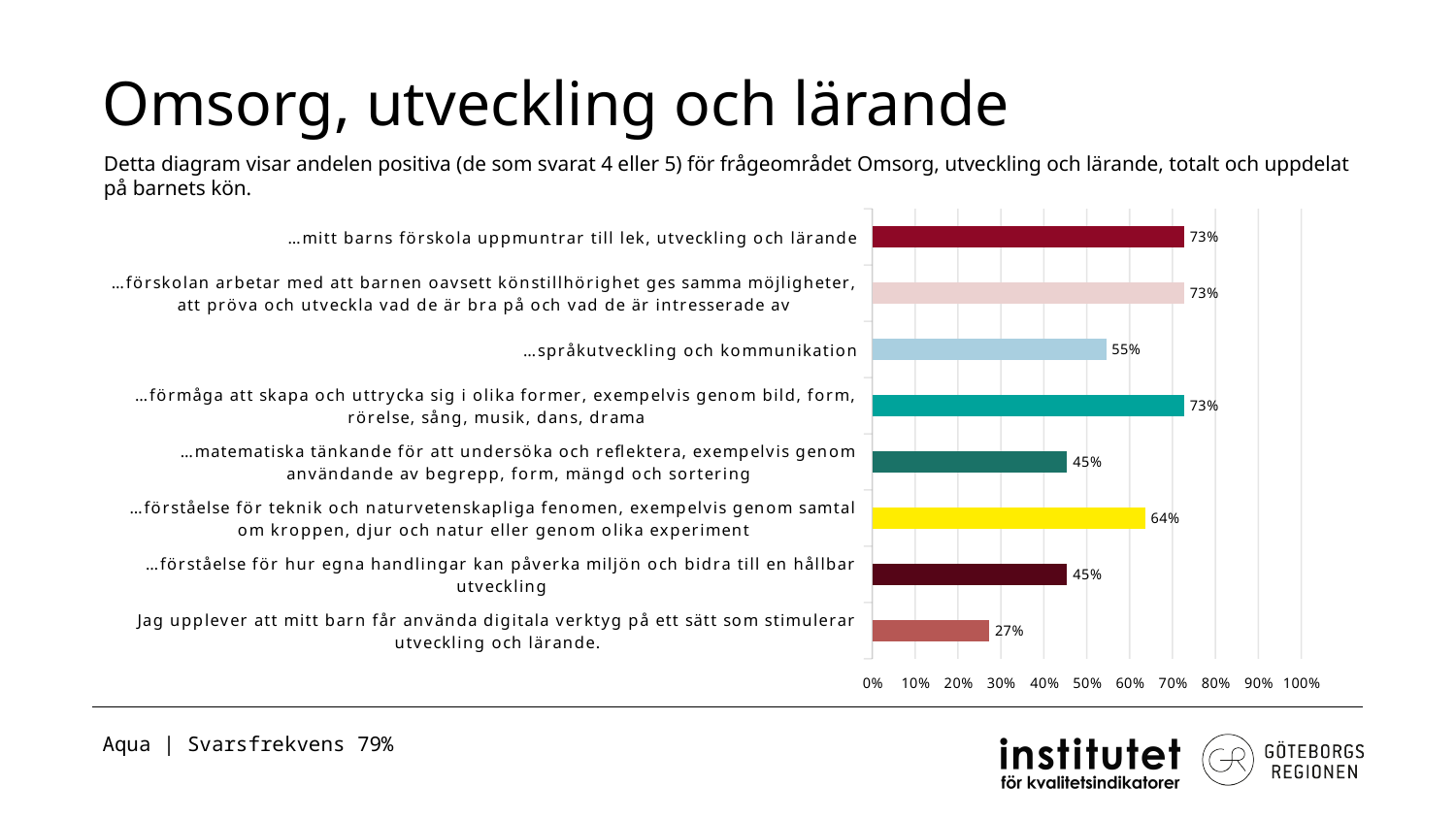
Which category has the lowest value? Jag upplever att mitt barn får använda digitala verktyg på ett sätt som stimulerar utveckling och lärande. What is the title of the slide? Omsorg, utveckling och lärande What kind of chart is shown on the slide? bar chart What is the value for "…matematiska tänkande för att undersöka och reflektera, exempelvis genom användande av begrepp, form, mängd och sortering"? 45% What is the difference between the value for "…förståelse för teknik och naturvetenskapliga fenomen…" and the value for "Jag upplever att mitt barn får använda digitala verktyg…"? 37 percentage points What is the value for "Jag upplever att mitt barn får använda digitala verktyg på ett sätt som stimulerar utveckling och lärande."? 27% How many categories are shown in the chart? 8 Which is larger: the value for "…språkutveckling och kommunikation" or the value for "…förståelse för hur egna handlingar kan påverka miljön och bidra till en hållbar utveckling"? …språkutveckling och kommunikation Is the value for "…förståelse för teknik och naturvetenskapliga fenomen…" greater or less than 50%? greater What is the value for "…förståelse för teknik och naturvetenskapliga fenomen, exempelvis genom samtal om kroppen, djur och natur eller genom olika experiment"? 64% What is the value for "…språkutveckling och kommunikation"? 55% What is the difference between the value for "…mitt barns förskola uppmuntrar till lek, utveckling och lärande" and the value for "…språkutveckling och kommunikation"? 18 percentage points